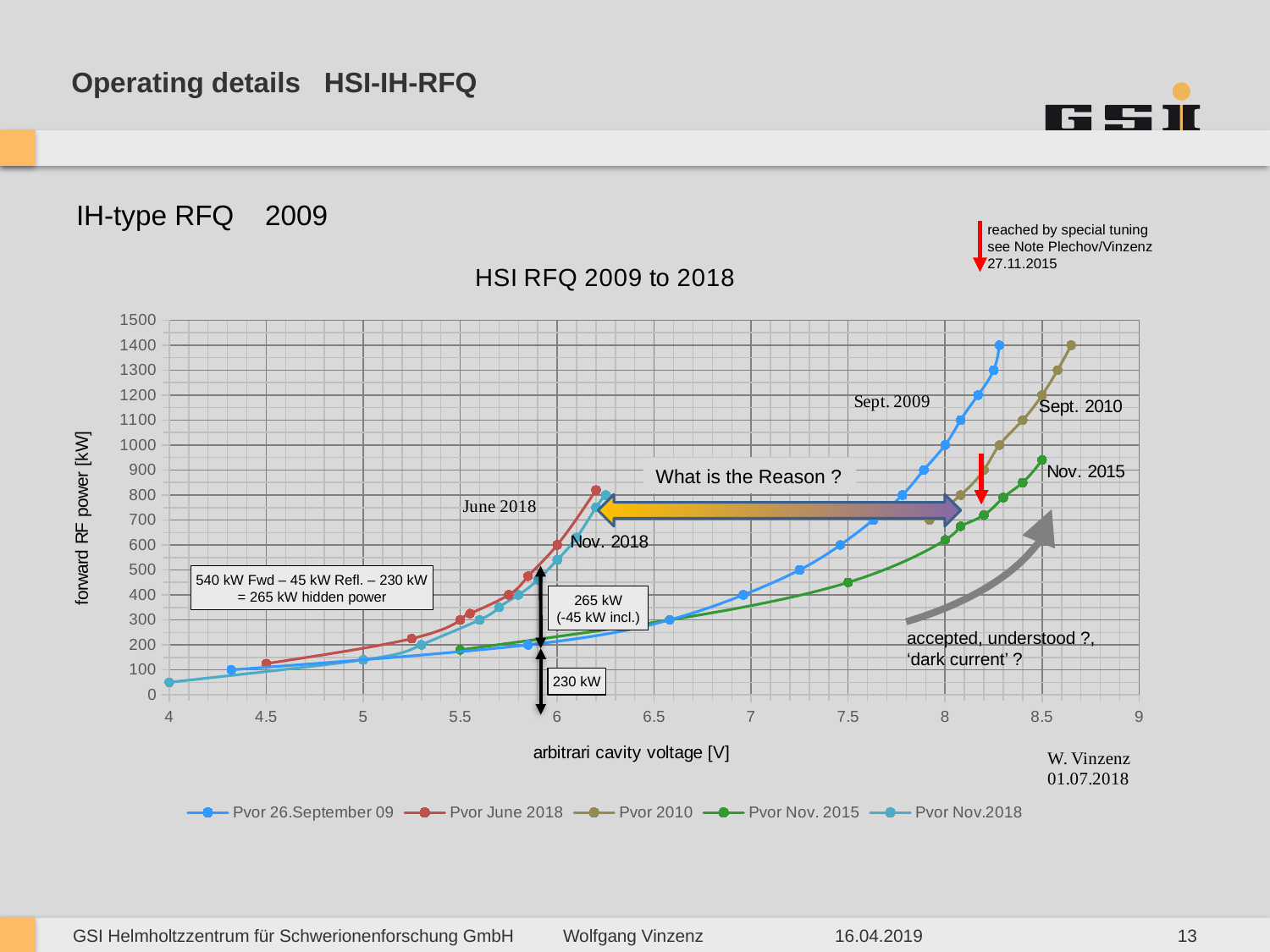
How many series does the chart legend list? 5 Is the highest value of the Pvor Nov. 2015 series greater or less than 1000? less Is the highest value of the Pvor June 2018 series greater or less than 700? greater At a cavity voltage of 7.5, which series has the larger forward RF power: Pvor 26.September 09 or Pvor Nov. 2015? Pvor 26.September 09 Is the highest value of the Pvor 2010 series greater or less than 1300? greater What is the label of the y axis of the chart? forward RF power [kW] What is the title of the chart? HSI RFQ 2009 to 2018 Do the values of the Pvor 2010 series rise or fall as the cavity voltage increases? rise Which series extends to the highest cavity voltage on the x axis? Pvor 2010 What kind of chart is shown on the slide? line chart